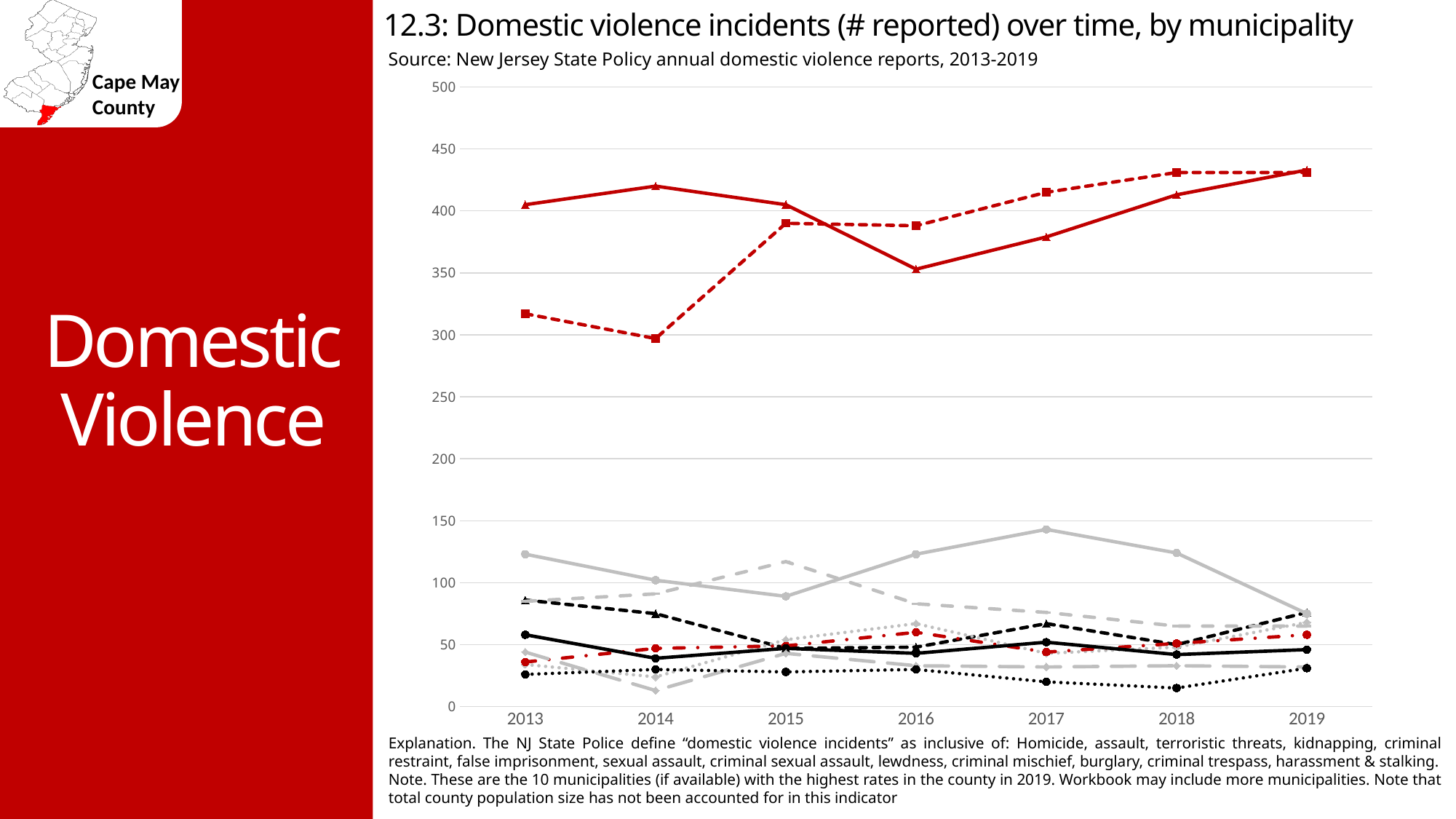
Is the value of the dashed red line in 2013 greater or less than 350? less Does the dashed red line rise or fall from 2014 to 2019? rises Is the value of the solid red line in 2016 greater or less than 400? less In 2013, which is higher: the solid red line or the dashed red line? the solid red line Is the value of the solid gray line in 2019 greater or less than 100? less What is the first year shown on the x axis of the chart? 2013 How many years are shown along the x axis of the chart? 7 What is the title of the chart? 12.3: Domestic violence incidents (# reported) over time, by municipality What kind of chart is shown on the slide? line chart